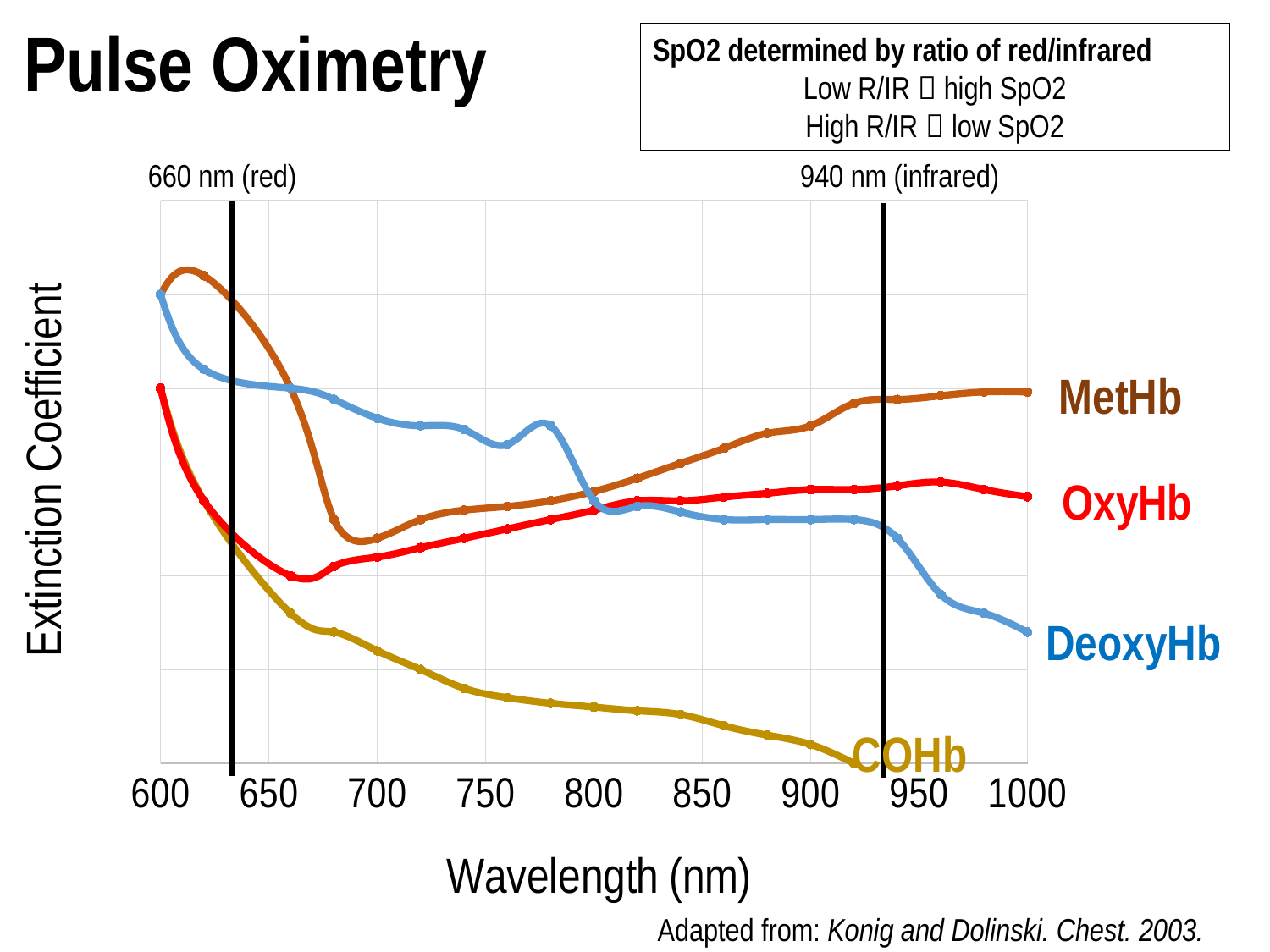
How many tick labels are shown on the x axis of the chart? 9 What is the title of the x axis of the chart? Wavelength (nm) At 940 nm, which series has the higher extinction coefficient, OxyHb or DeoxyHb? OxyHb Does the COHb line rise or fall as wavelength increases from 600 nm to 900 nm? fall Which series has the lowest extinction coefficient at 800 nm? COHb At 660 nm, which series has the higher extinction coefficient, OxyHb or DeoxyHb? DeoxyHb Which series has the lowest extinction coefficient at 900 nm? COHb How many series are labelled on the chart? 4 What wavelength does the right-hand vertical black line mark on the chart? 940 nm (infrared) Does the MetHb line rise or fall as wavelength increases from 700 nm to 1000 nm? rise Which series has the highest extinction coefficient at 1000 nm? MetHb What kind of chart is shown on the slide? line chart